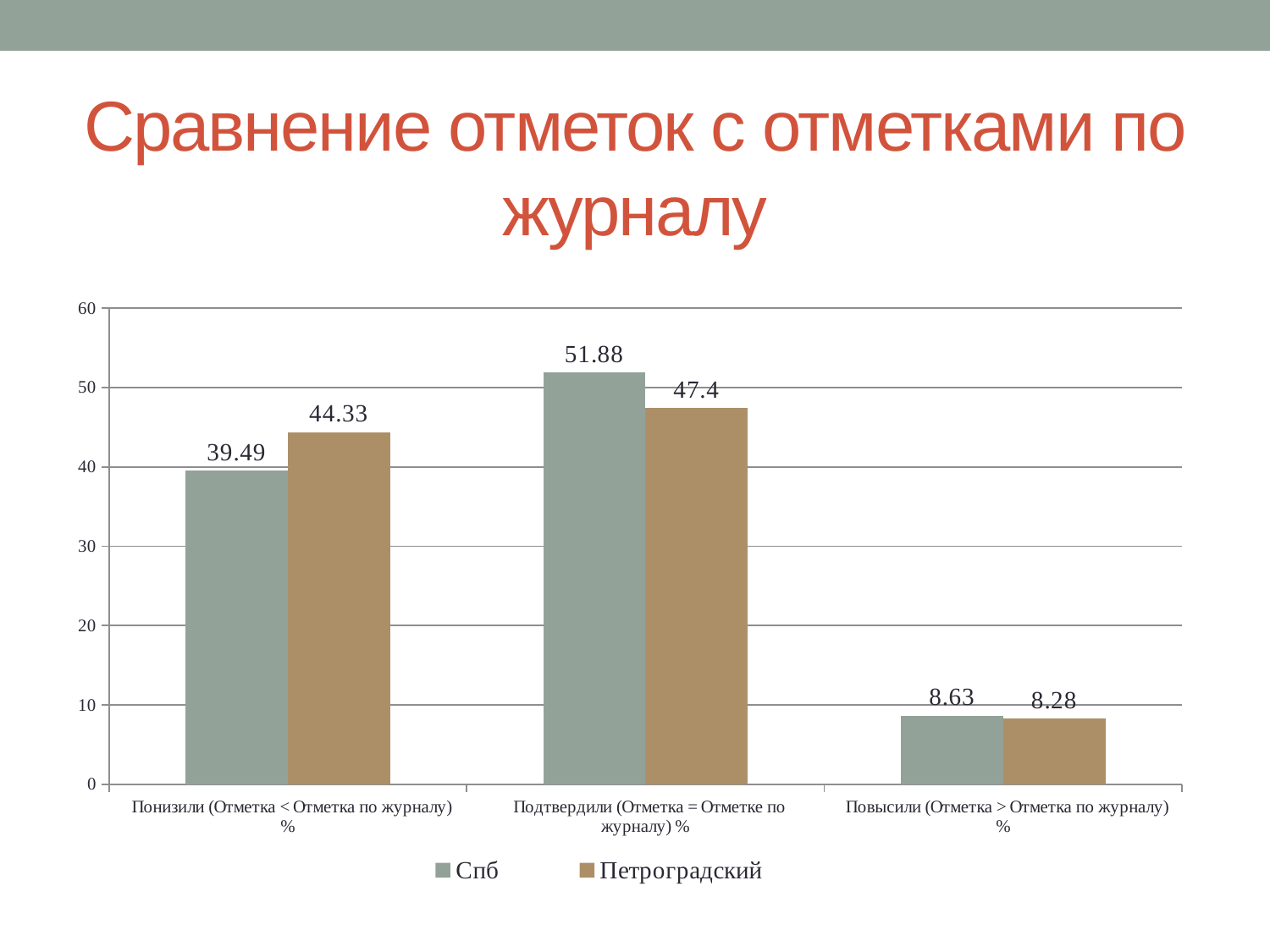
What is the value for Петроградский in the category 'Повысили (Отметка > Отметка по журналу) %'? 8.28 Which category has the lowest value for Петроградский? Повысили (Отметка > Отметка по журналу) % What is the title of the slide? Сравнение отметок с отметками по журналу What is the value for Спб in the category 'Понизили (Отметка < Отметка по журналу) %'? 39.49 Is the value for Спб in the category 'Повысили (Отметка > Отметка по журналу) %' greater or less than 10? less How many series does the legend list? 2 What is the value for Петроградский in the category 'Подтвердили (Отметка = Отметке по журналу) %'? 47.4 Which category has the highest value for Спб? Подтвердили (Отметка = Отметке по журналу) % How many categories are shown on the x axis? 3 What kind of chart is shown on the slide? bar chart Which series has the larger value in the category 'Подтвердили (Отметка = Отметке по журналу) %', Спб or Петроградский? Спб What is the difference between Спб and Петроградский in the category 'Понизили (Отметка < Отметка по журналу) %'? 4.84